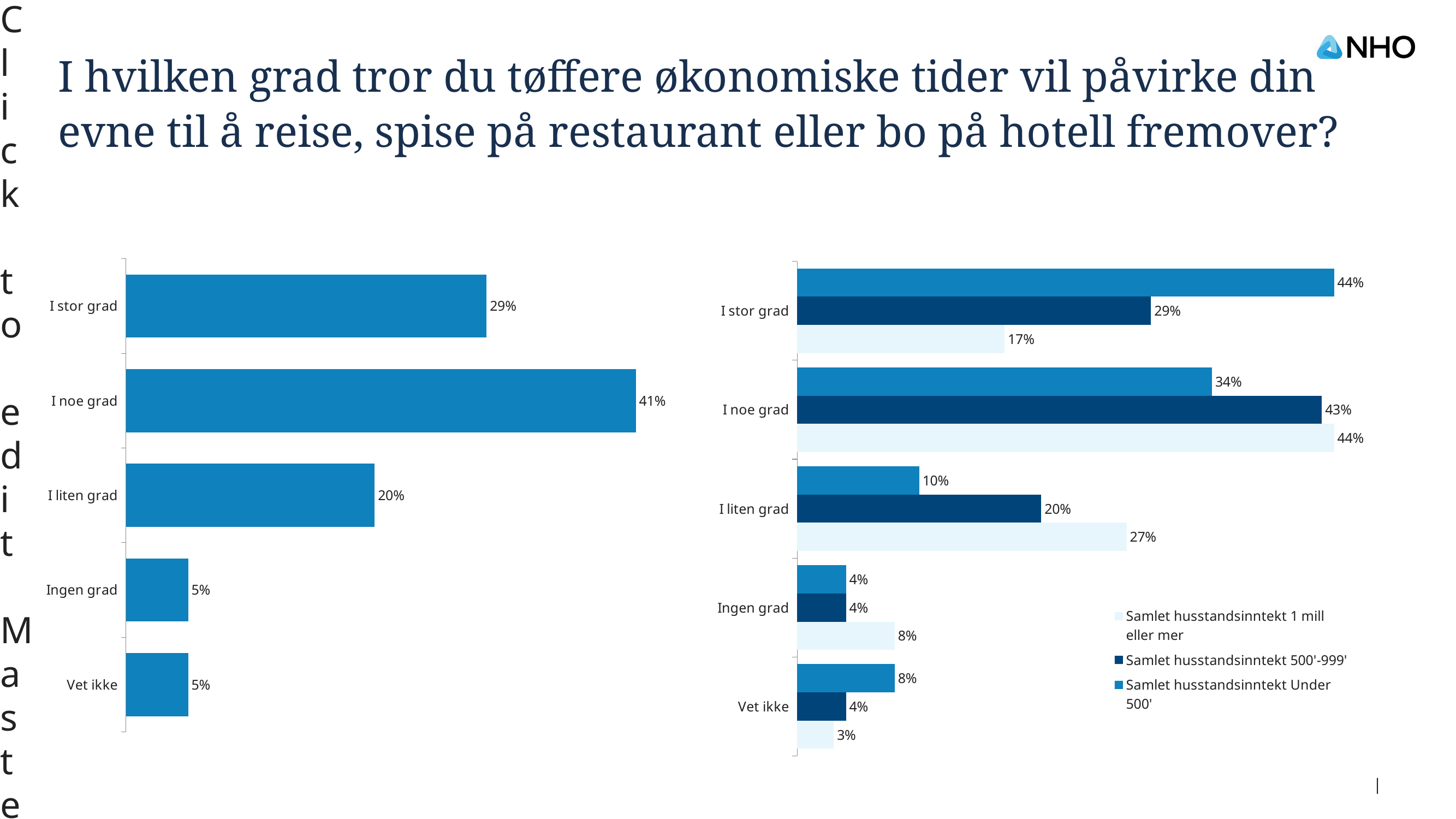
In the right chart, for "Vet ikke", is the value for "Samlet husstandsinntekt Under 500'" larger or smaller than the value for "Samlet husstandsinntekt 500'-999'"? Larger In the right chart, what is the value for "I liten grad" in the series "Samlet husstandsinntekt 1 mill eller mer"? 27% In the right chart, how many series does the legend list? 3 In the right chart, what is the value for "I stor grad" in the series "Samlet husstandsinntekt Under 500'"? 44% In the right chart, for "I stor grad", which series has the lowest value? Samlet husstandsinntekt 1 mill eller mer In the left chart, what is the value for "I noe grad"? 41% In the right chart, what is the value for "Ingen grad" in the series "Samlet husstandsinntekt 500'-999'"? 4% What kind of chart is the left chart? Bar chart In the left chart, how many categories are shown? 5 In the left chart, what is the difference between "I noe grad" and "I stor grad"? 12 percentage points In the left chart, which category has the highest value? I noe grad In the right chart, what is the difference between "Samlet husstandsinntekt Under 500'" and "Samlet husstandsinntekt 1 mill eller mer" for "I stor grad"? 27 percentage points